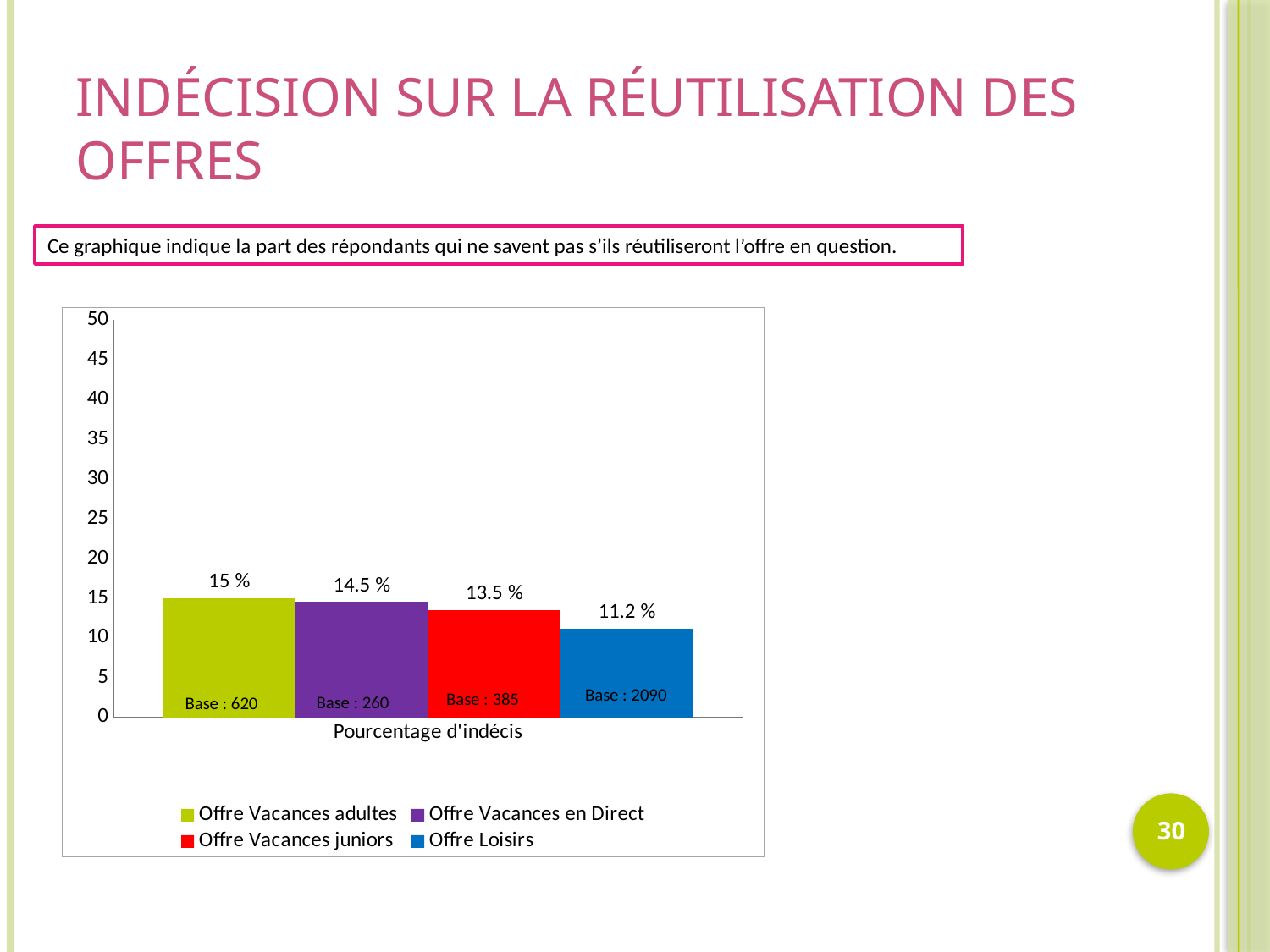
What is the value for Offre Loisirs? 11.2 % Which series has the highest percentage of undecided respondents? Offre Vacances adultes Which is larger, the value for Offre Vacances juniors or the value for Offre Loisirs? Offre Vacances juniors What is the value for Offre Vacances en Direct? 14.5 % Which series has the lowest percentage of undecided respondents? Offre Loisirs What is the value for Offre Vacances juniors? 13.5 % How many series does the legend list? 4 Is the value for Offre Loisirs greater or less than 15? less What is the value for Offre Vacances adultes? 15 % What kind of chart is shown on the slide? Bar chart What is the difference between the values for Offre Vacances adultes and Offre Loisirs? 3.8 % What base (number of respondents) is shown on the bar for Offre Loisirs? Base : 2090